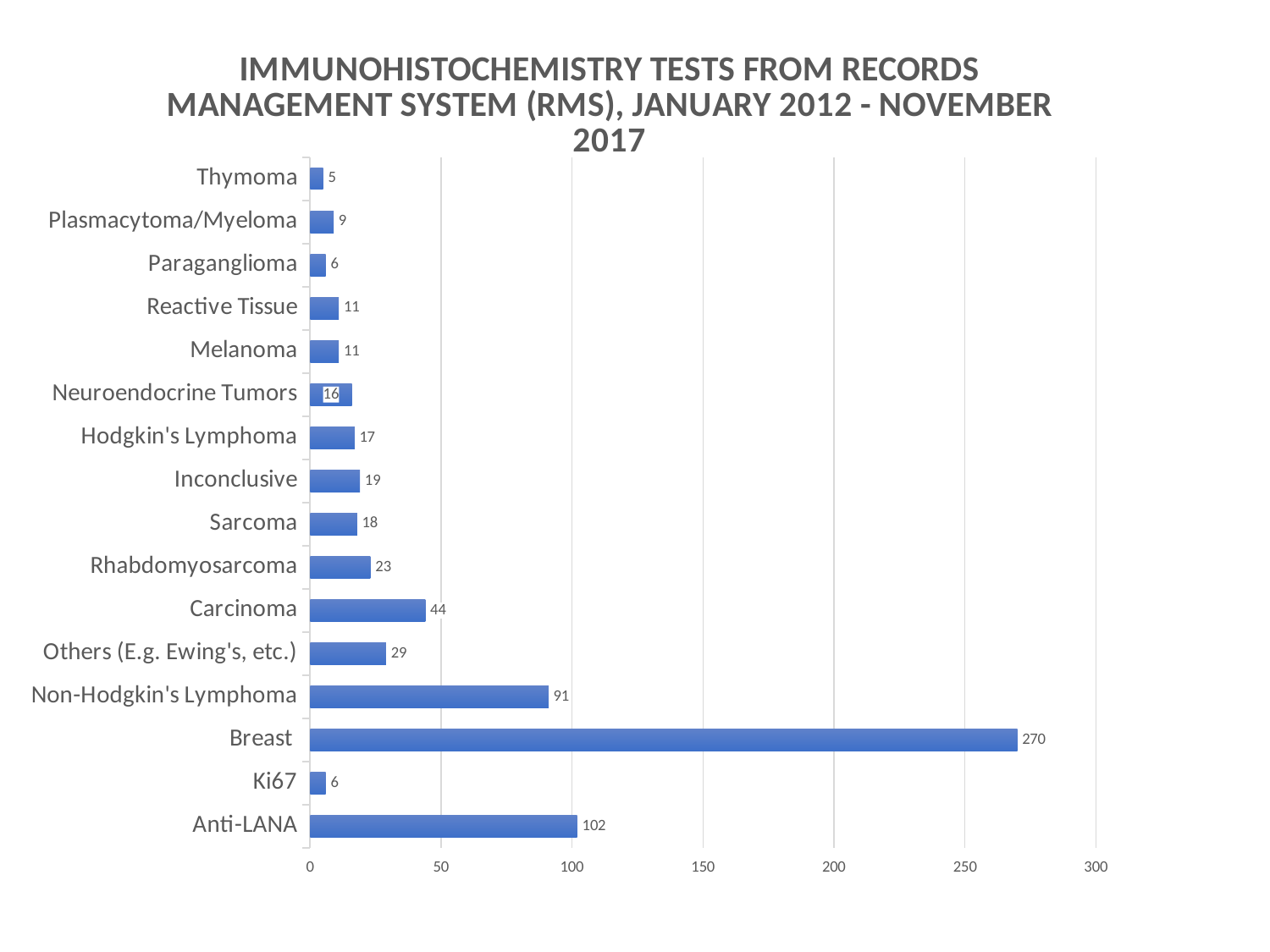
What is the difference between the values for Inconclusive and Sarcoma? 1 What is the value for Non-Hodgkin's Lymphoma? 91 Which is larger, the value for Carcinoma or the value for Others (E.g. Ewing's, etc.)? Carcinoma How many categories are shown in the chart? 16 What kind of chart is shown on the slide? bar chart What is the value for Breast? 270 Is the value for Non-Hodgkin's Lymphoma greater or less than 100? less Which category has the lowest value? Thymoma What is the value for Anti-LANA? 102 What is the value for Rhabdomyosarcoma? 23 What is the difference between the values for Breast and Anti-LANA? 168 Which category has the highest value? Breast